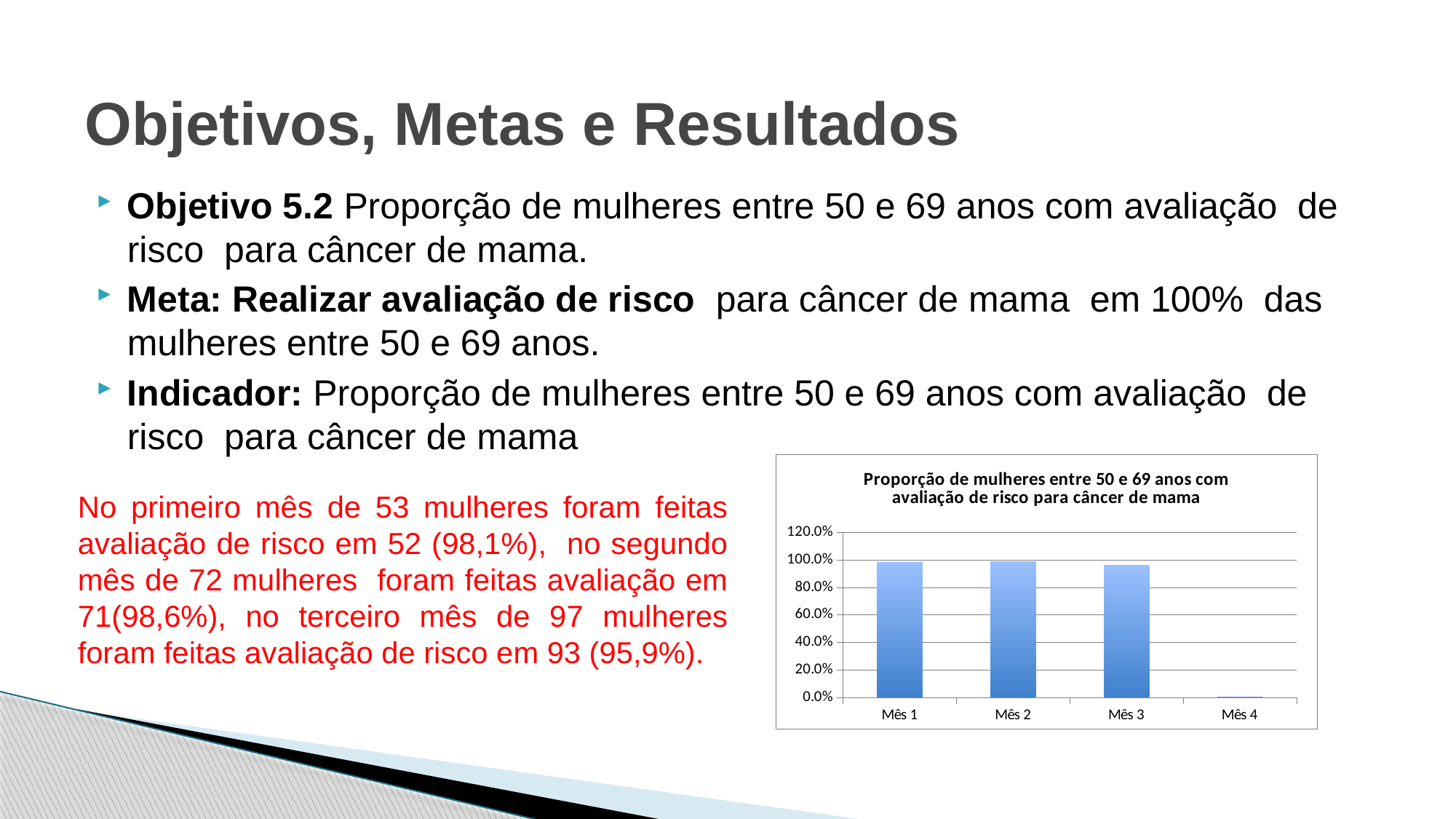
What is the title of the chart? Proporção de mulheres entre 50 e 69 anos com avaliação de risco para câncer de mama Is the value for Mês 2 greater or less than 100.0%? less Is the value for Mês 4 greater or less than 20.0%? less Which is larger, the value for Mês 4 or the value for Mês 2? Mês 2 Is the value for Mês 1 greater or less than 80.0%? greater How many categories (months) are shown on the x axis of the chart? 4 What is the highest tick value shown on the chart's y axis? 120.0% Does the value rise or fall from Mês 3 to Mês 4? fall What kind of chart is shown on the slide? bar chart Which is larger, the value for Mês 1 or the value for Mês 4? Mês 1 Which month has the lowest value in the chart? Mês 4